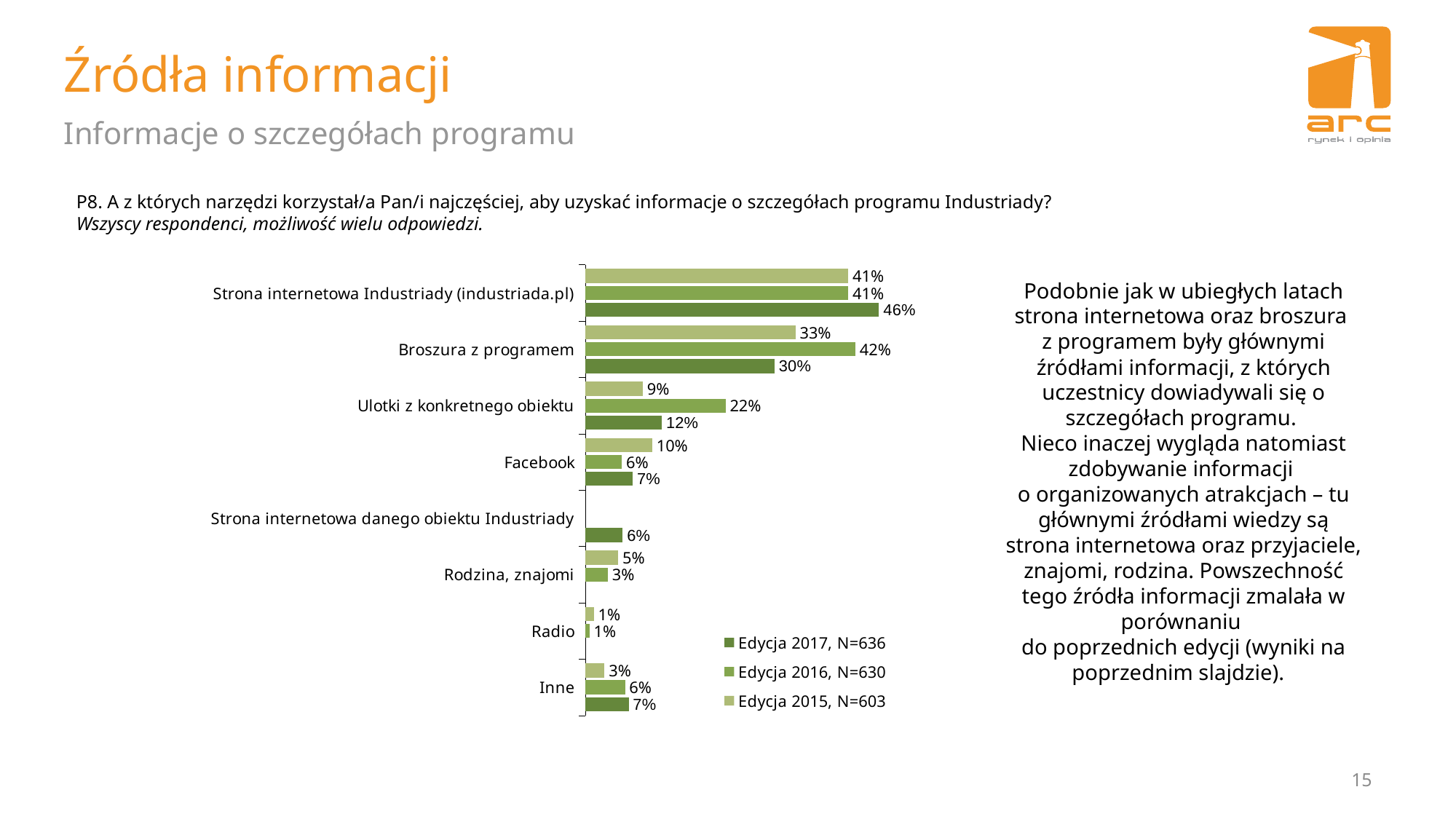
Which is larger for Ulotki z konkretnego obiektu: the Edycja 2016 value or the Edycja 2017 value? Edycja 2016 How many categories are shown on the chart? 8 Which category has the lowest value in Edycja 2016? Radio What is the value for Ulotki z konkretnego obiektu in Edycja 2015? 9% What is the value for Strona internetowa Industriady (industriada.pl) in Edycja 2017? 46% What is the value for Broszura z programem in Edycja 2016? 42% What kind of chart is shown on the slide? bar chart What is the difference between the Edycja 2016 and Edycja 2017 values for Broszura z programem? 12% What is the value for Facebook in Edycja 2017? 7% What sample size (N) does the legend give for Edycja 2015? N=603 Which category has the highest value in Edycja 2017? Strona internetowa Industriady (industriada.pl) How many series does the legend list? 3